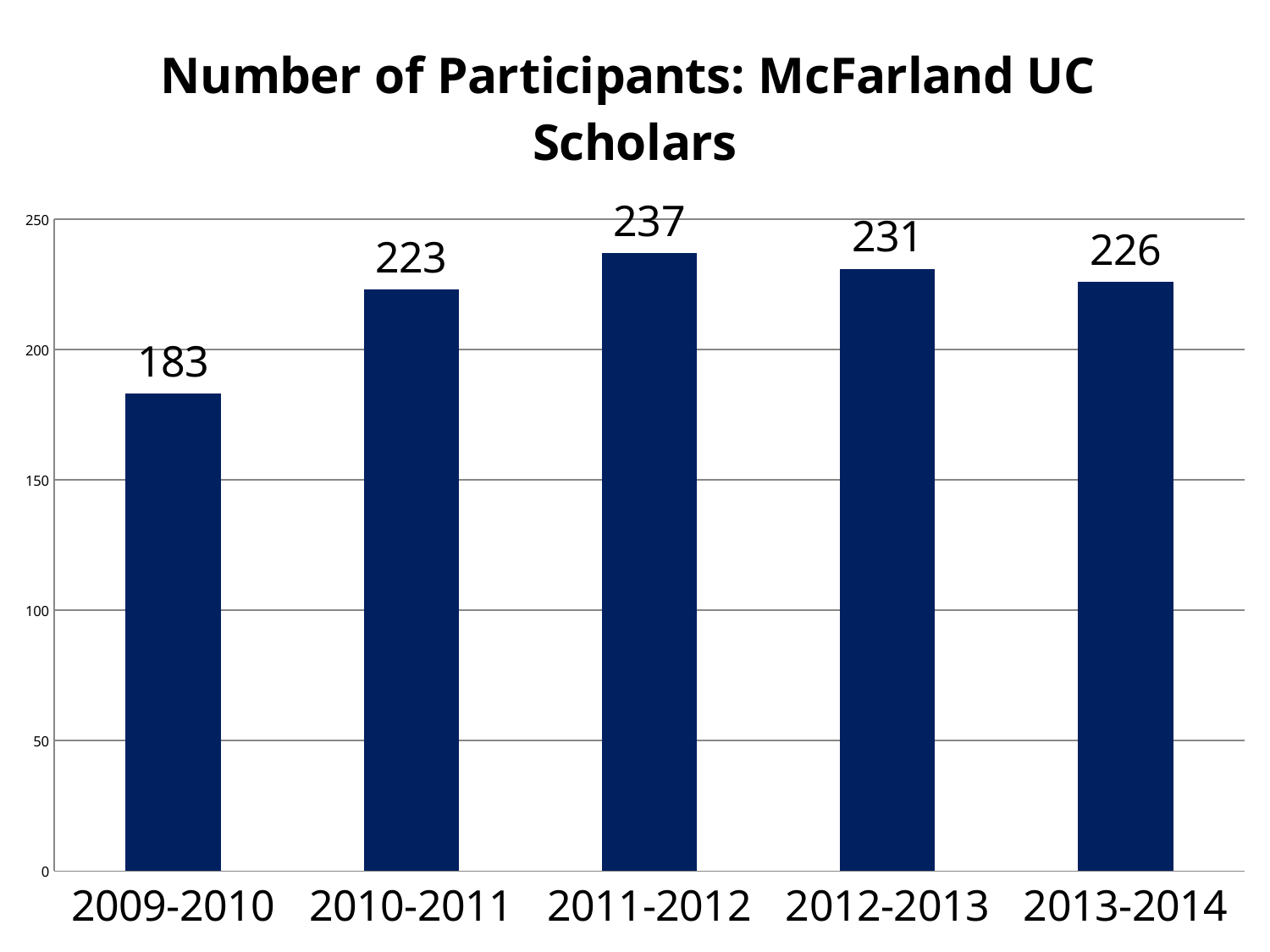
What is the title of the chart? Number of Participants: McFarland UC Scholars What is the difference in participants between 2011-2012 and 2009-2010? 54 Which has more participants, 2010-2011 or 2012-2013? 2012-2013 What kind of chart is shown on the slide? bar chart What is the difference in participants between 2012-2013 and 2013-2014? 5 What is the number of participants for 2011-2012? 237 What is the number of participants for 2009-2010? 183 Which year has the lowest number of participants? 2009-2010 Which year has the highest number of participants? 2011-2012 What is the number of participants for 2013-2014? 226 How many academic years are shown on the chart? 5 Is the value for 2009-2010 greater or less than 200? less